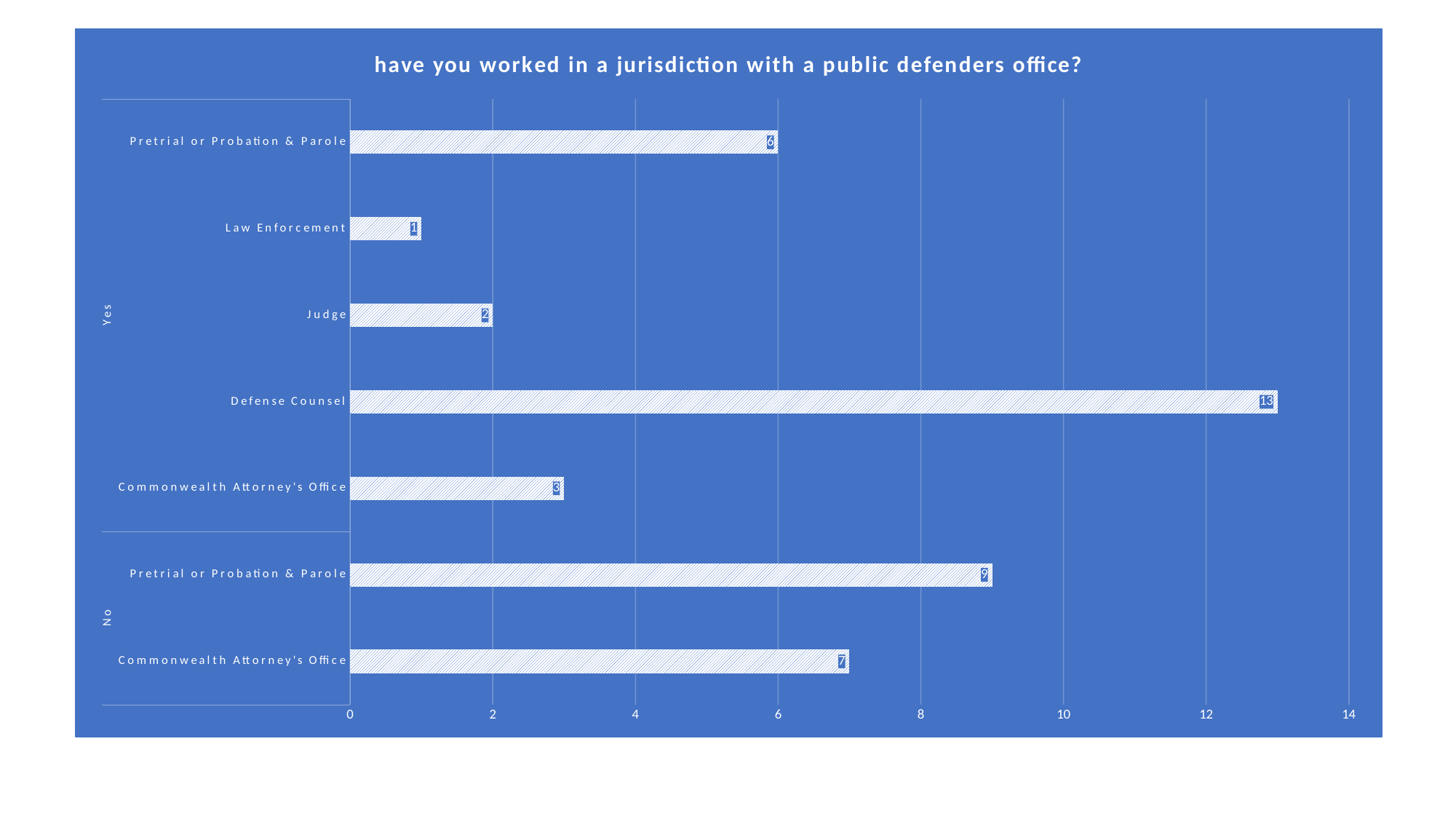
What kind of chart is shown on the slide? Bar chart What is the value for Commonwealth Attorney's Office in the No group? 7 Which category has the lowest value on the chart? Law Enforcement (Yes) What is the title of the chart? have you worked in a jurisdiction with a public defenders office? Which is larger: Commonwealth Attorney's Office in the Yes group or in the No group? No group What is the value for Pretrial or Probation & Parole in the No group? 9 Is the value for Judge in the Yes group greater or less than 4? less What is the value for Law Enforcement in the Yes group? 1 What is the difference between the Pretrial or Probation & Parole values in the No group and the Yes group? 3 How many bars are plotted on the chart? 7 Which category has the highest value on the chart? Defense Counsel (Yes) What is the value for Defense Counsel in the Yes group? 13